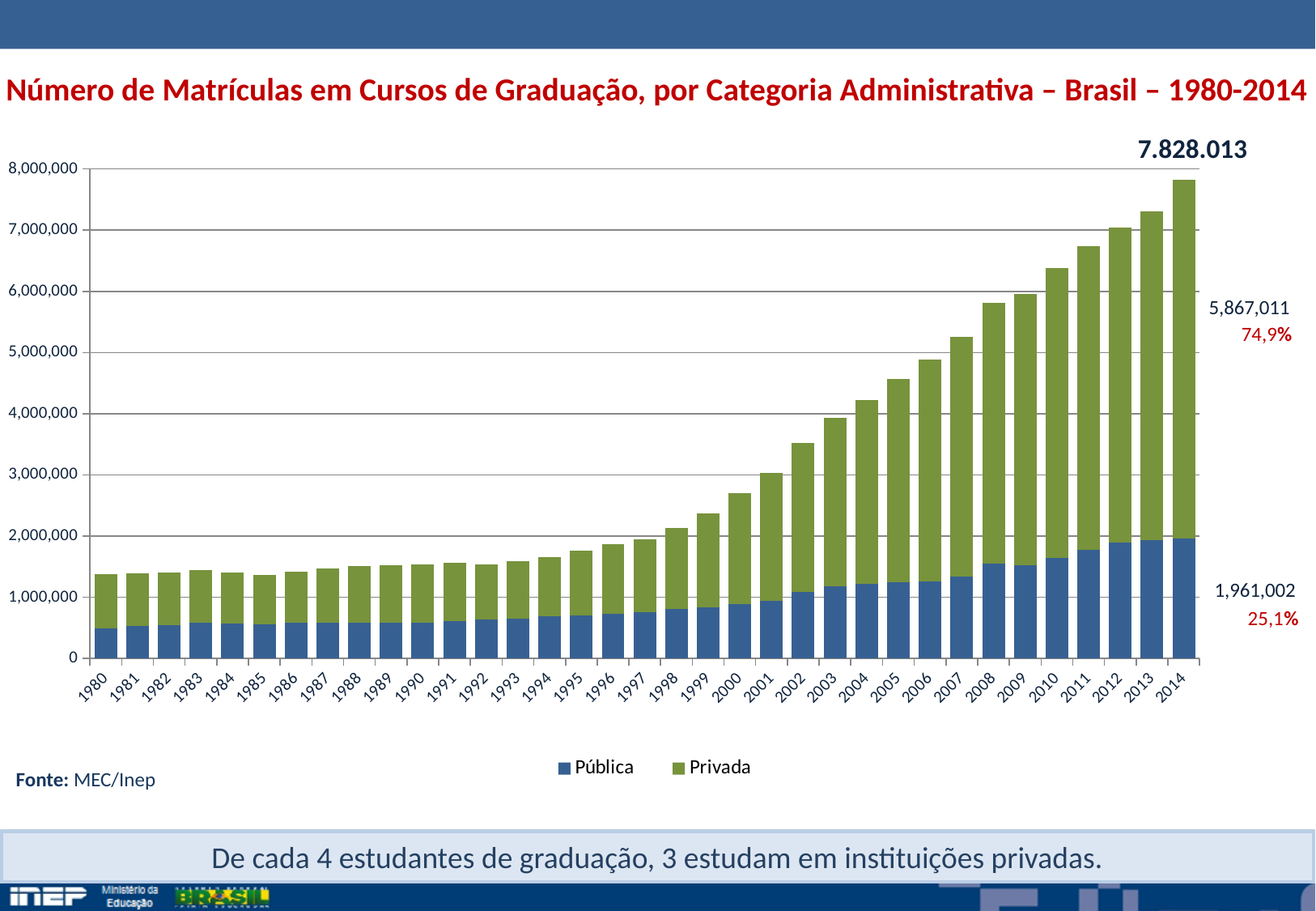
What is the difference between the Privada and Pública values in 2014? 3,906,009 What are the two series named in the legend? Pública and Privada What is the value for Privada in 2014? 5,867,011 What is the value for Pública in 2014? 1,961,002 What is the total number of enrolments shown for 2014? 7.828.013 How many series does the legend list? 2 What percentage share of 2014 enrolments is Privada? 74,9% How many years (bars) are plotted along the x axis? 35 Do the total enrolments generally rise or fall from 1980 to 2014? Rise Which year has the highest total bar? 2014 What kind of chart is shown on the slide? Stacked bar chart Is the total value for 2000 greater or less than 2,000,000? greater